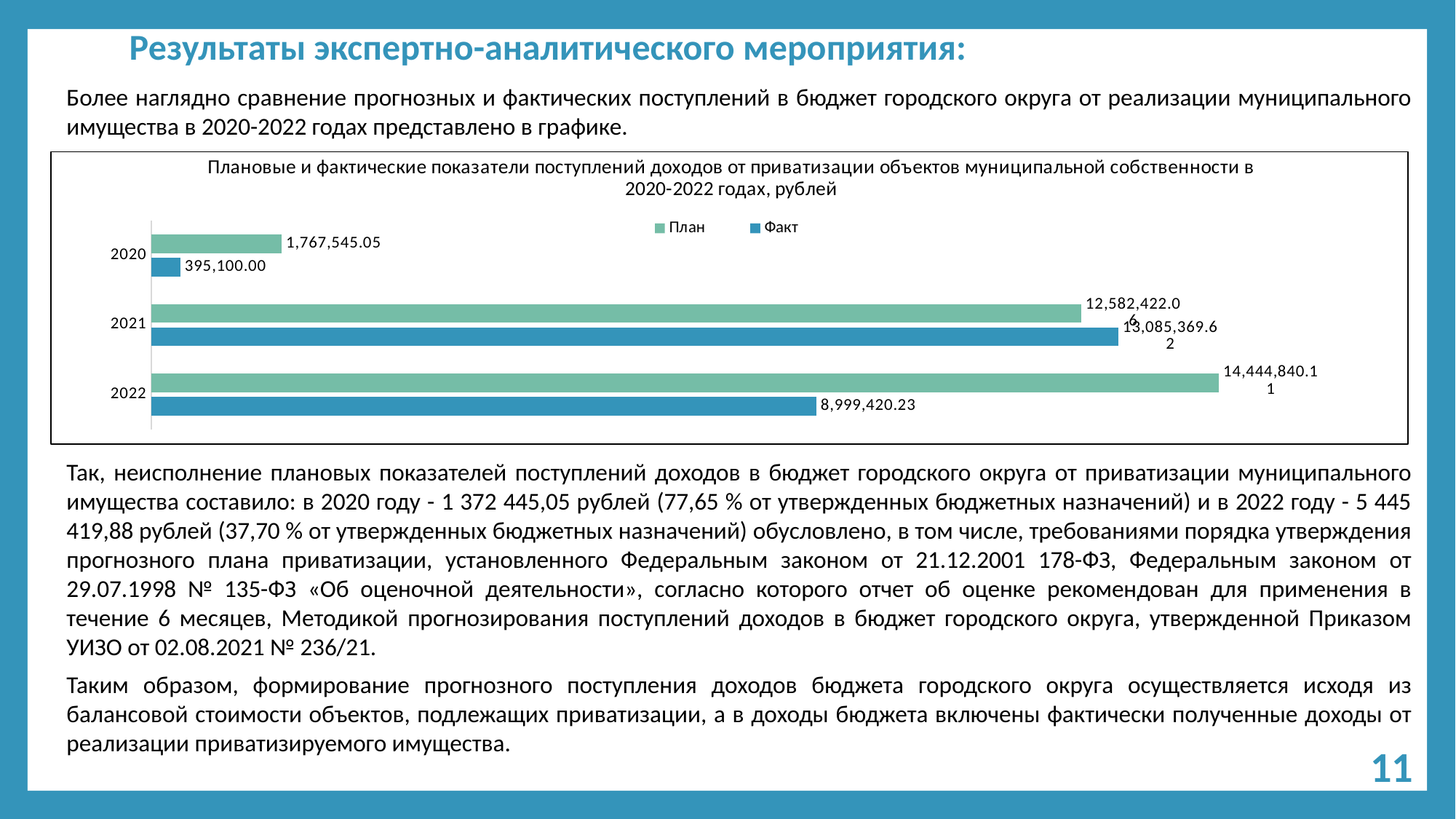
Which year has the lowest Факт value? 2020 Which year has the highest План value? 2022 What is the План value for 2021? 12,582,422.06 What is the Факт value for 2022? 8,999,420.23 What are the two series named in the chart legend? План and Факт How many series does the chart legend list? 2 What is the План value for 2020? 1,767,545.05 What kind of chart is shown on the slide? Bar chart What is the Факт value for 2020? 395,100.00 In 2022, which is larger: План or Факт? План What is the difference between the План and Факт values for 2020? 1,372,445.05 How many years (categories) are shown on the chart? 3